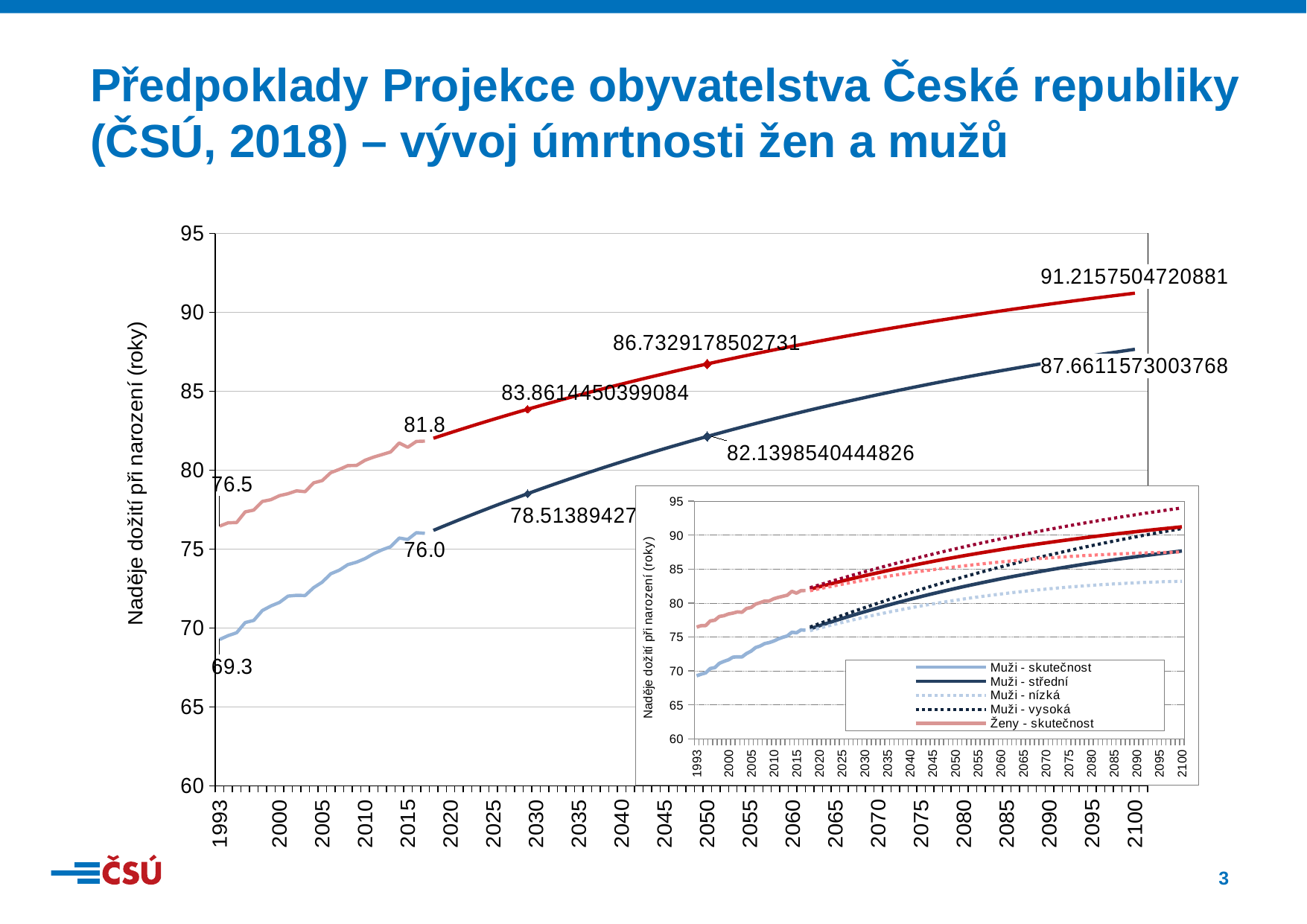
What type of chart is the main chart on the slide? line chart On the main chart, what value is labelled at the end (2100) of the lower dark-blue line? 87.6611573003768 On the main chart, what is the difference between the labelled values 81.8 and 76.0 at the end of the actual-data lines? 5.8 On the main chart, what value is labelled on the red line at 2050? 86.7329178502731 On the main chart, what value is labelled at the start (1993) of the lower light-blue line? 69.3 On the main chart, what value is labelled at the start (1993) of the upper pink line? 76.5 On the main chart, what value is labelled at the end (2100) of the upper red line? 91.2157504720881 How many series does the legend of the inset chart list? 5 On the main chart, what value is labelled on the dark-blue line at 2050? 82.1398540444826 On the main chart, what is the difference between the two labelled 1993 values, 76.5 and 69.3? 7.2 On the main chart, do the lines rise or fall from 1993 to 2100? rise What is the y-axis title of the main chart? Naděje dožití při narození (roky)